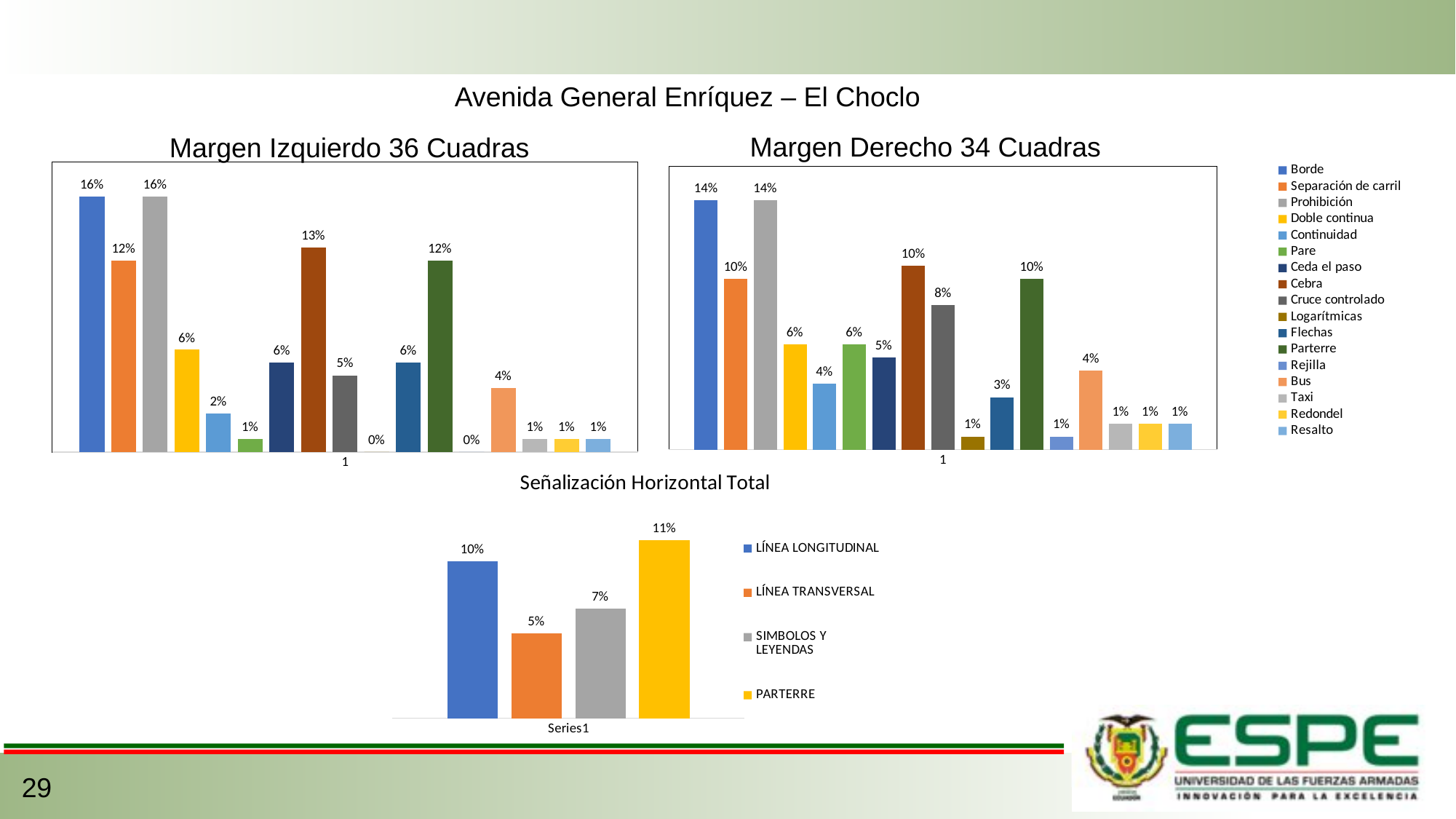
In the 'Margen Izquierdo 36 Cuadras' chart, what is the difference between the values for Borde and Separación de carril? 4% In the 'Margen Derecho 34 Cuadras' chart, which is larger, the value for Cebra or the value for Cruce controlado? Cebra In the 'Señalización Horizontal Total' chart, what is the value for LÍNEA TRANSVERSAL? 5% How many series does the legend of the 'Señalización Horizontal Total' chart list? 4 In the 'Margen Izquierdo 36 Cuadras' chart, what is the value for Cebra? 13% In the 'Señalización Horizontal Total' chart, what is the difference between the values for PARTERRE and SIMBOLOS Y LEYENDAS? 4% How many series does the legend shared by the 'Margen Izquierdo' and 'Margen Derecho' charts list? 17 In the 'Señalización Horizontal Total' chart, which category has the highest value? PARTERRE In the 'Margen Derecho 34 Cuadras' chart, what is the value for Cruce controlado? 8% In the 'Señalización Horizontal Total' chart, which category has the lowest value? LÍNEA TRANSVERSAL What kind of chart is the 'Señalización Horizontal Total' chart? Bar chart What is the overall title at the top of the slide? Avenida General Enríquez – El Choclo